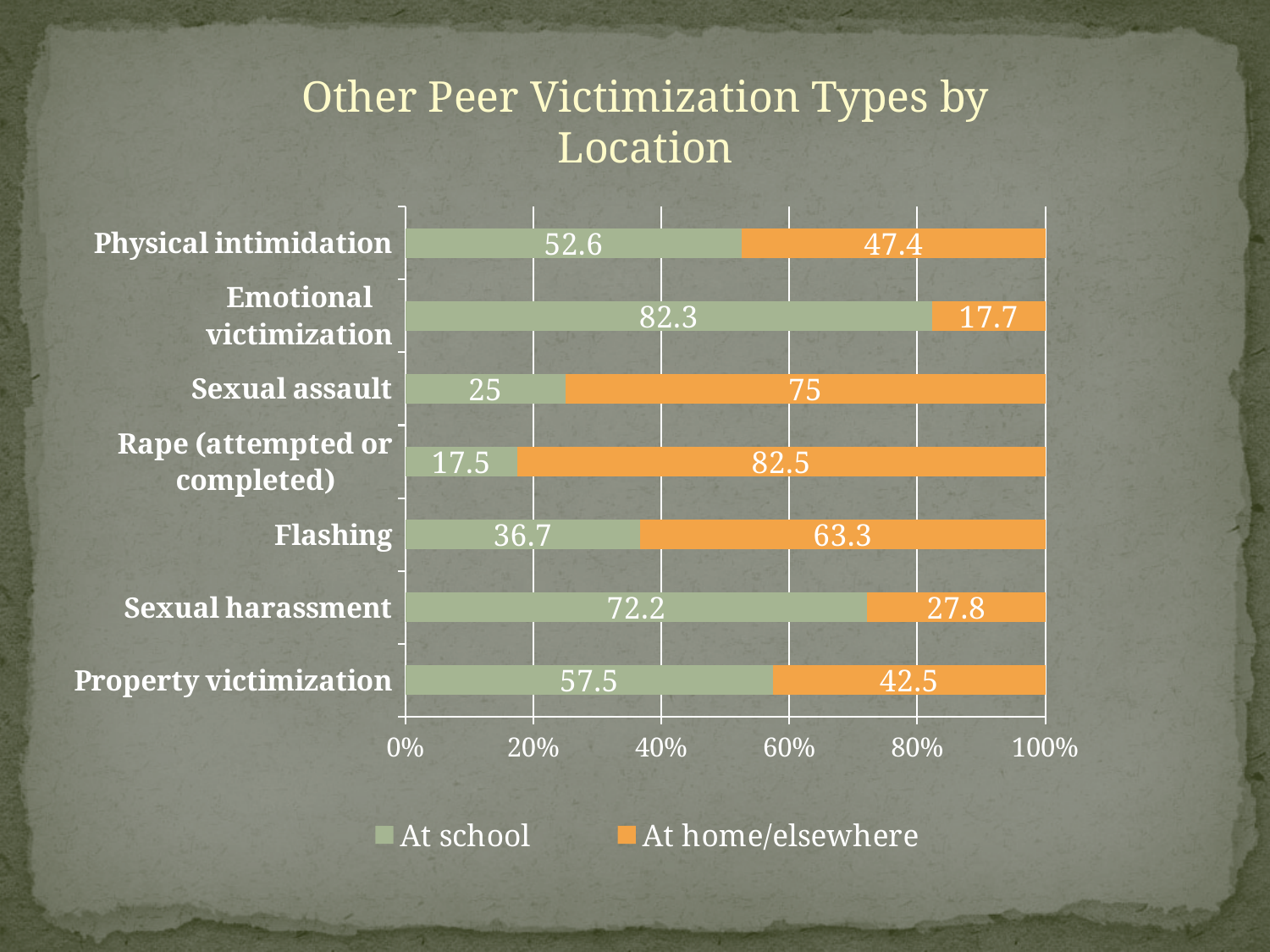
What is the difference between the 'At school' and 'At home/elsewhere' values for Sexual harassment? 44.4 How many categories are shown on the chart? 7 Which category has the highest 'At home/elsewhere' value? Rape (attempted or completed) What kind of chart is shown on the slide? Stacked bar chart How many series does the legend list? 2 Which is larger for Sexual assault: the 'At school' value or the 'At home/elsewhere' value? At home/elsewhere What is the 'At school' value for Rape (attempted or completed)? 17.5 What is the 'At school' value for Emotional victimization? 82.3 Which category has the highest 'At school' value? Emotional victimization What is the 'At home/elsewhere' value for Flashing? 63.3 Which category has the lowest 'At school' value? Rape (attempted or completed) What is the title of the chart? Other Peer Victimization Types by Location